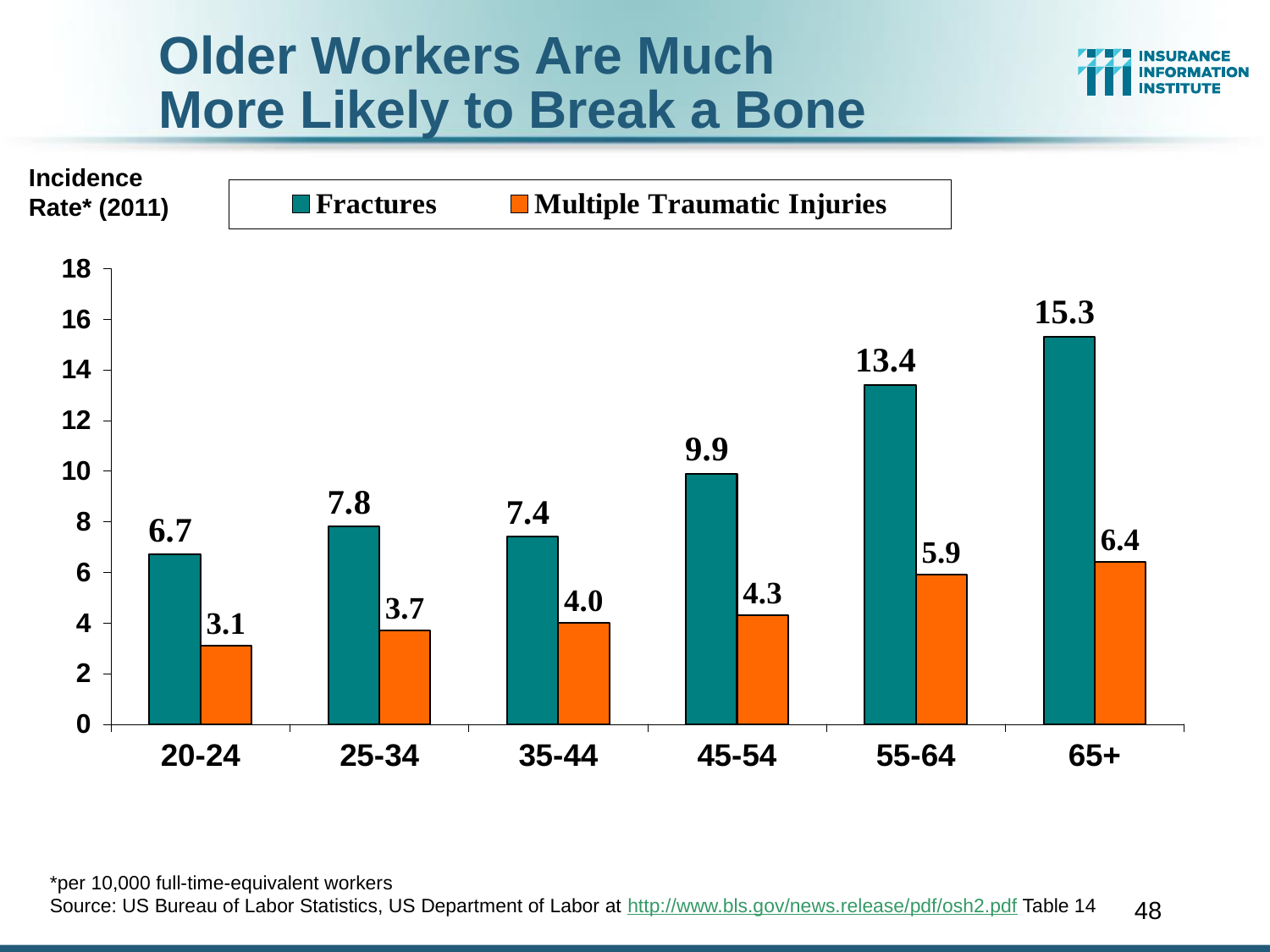
What is the Multiple Traumatic Injuries incidence rate for the 25-34 age group? 3.7 What is the difference in Fractures incidence rate between the 55-64 and 20-24 age groups? 6.7 How many series does the legend list? 2 What is the difference between the Fractures rate and the Multiple Traumatic Injuries rate for the 65+ age group? 8.9 Does the Multiple Traumatic Injuries rate rise or fall as age group increases from 20-24 to 65+? Rises Is the Fractures rate for the 55-64 age group greater or less than 12? greater What is the Fractures incidence rate for the 45-54 age group? 9.9 Which is larger, the Fractures rate for 25-34 or the Fractures rate for 35-44? 25-34 What kind of chart is shown on the slide? Bar chart Which age group has the lowest Multiple Traumatic Injuries incidence rate? 20-24 Which age group has the highest Fractures incidence rate? 65+ How many age groups are shown on the x axis? 6